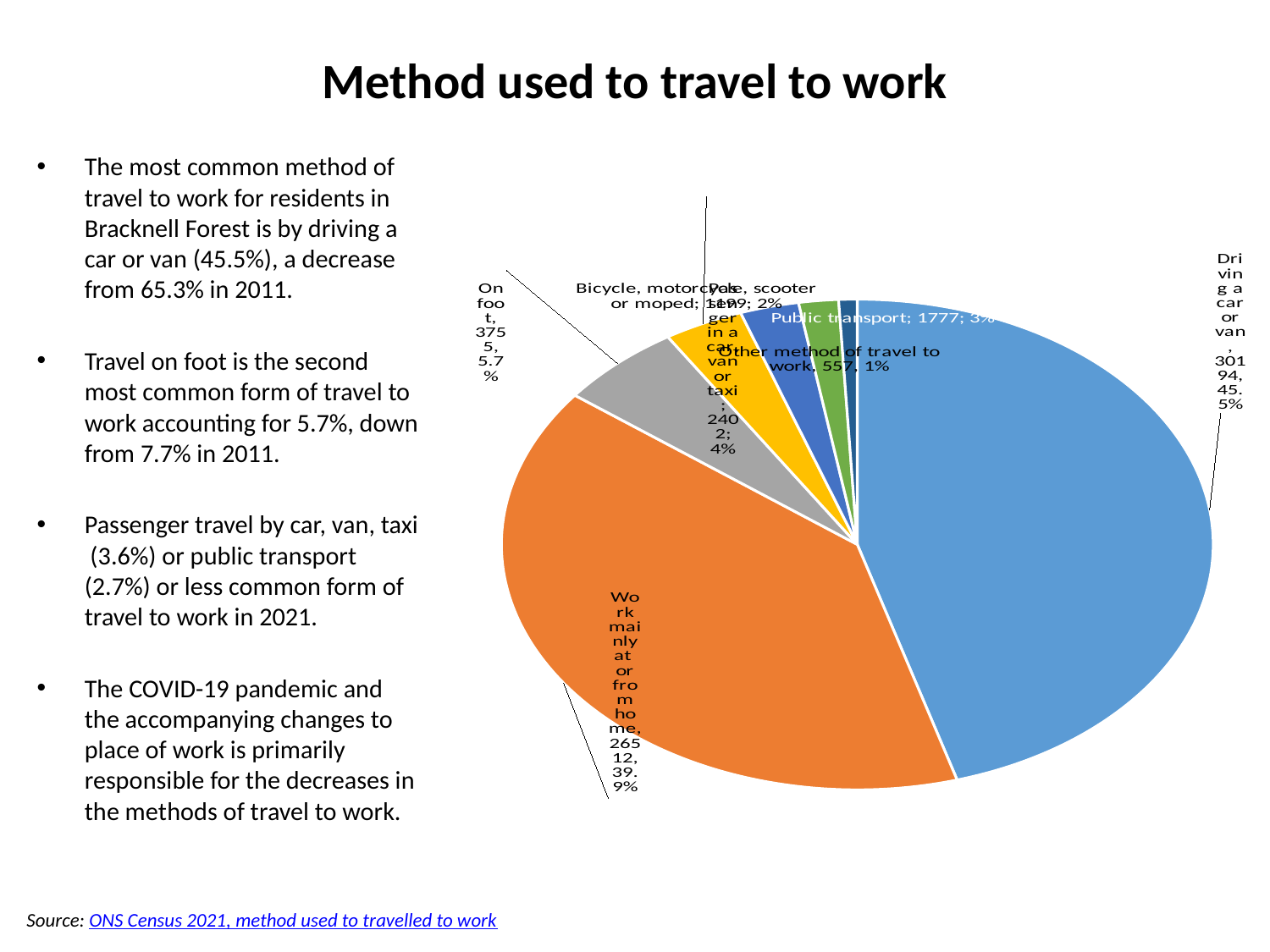
What is the difference between the values for 'Driving a car or van' and 'Work mainly at or from home'? 3682 Which category has the smallest slice of the pie? Other method of travel to work What share of the pie does 'Driving a car or van' represent? 45.5% What is the value shown for 'Other method of travel to work'? 557 What is the value shown for 'Work mainly at or from home'? 26512 What is the value shown for 'Public transport'? 1777 Which category has the largest slice of the pie? Driving a car or van What kind of chart is shown on the slide? pie chart How many people are shown for 'Driving a car or van'? 30194 What is the value shown for 'On foot'? 3755 What is the title of the chart? Method used to travel to work What percentage of the pie is 'Work mainly at or from home'? 39.9%